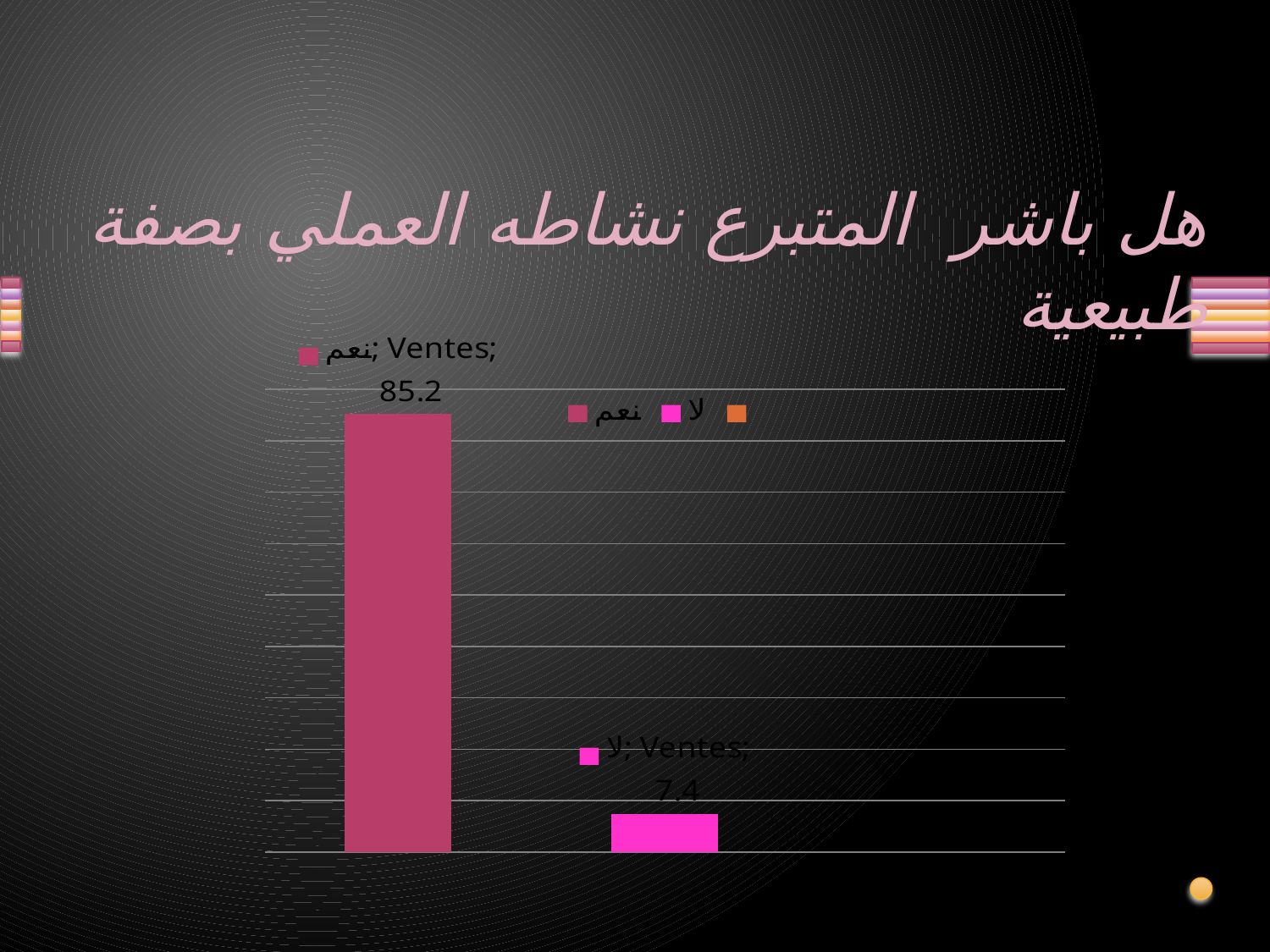
What kind of chart is shown on the slide? bar chart How many entries does the legend list? 3 Which category has the highest value? نعم What is the value shown for the نعم bar? 85.2 Which is larger, the value for نعم or the value for لا? نعم Which category has the lowest value? لا How many bars are plotted in the chart? 2 What is the title of the slide above the chart? هل باشر المتبرع نشاطه العملي بصفة طبيعية What is the difference between the values for نعم and لا? 77.8 What series name appears in the data labels of the bars? Ventes What is the value shown for the لا bar? 7.4